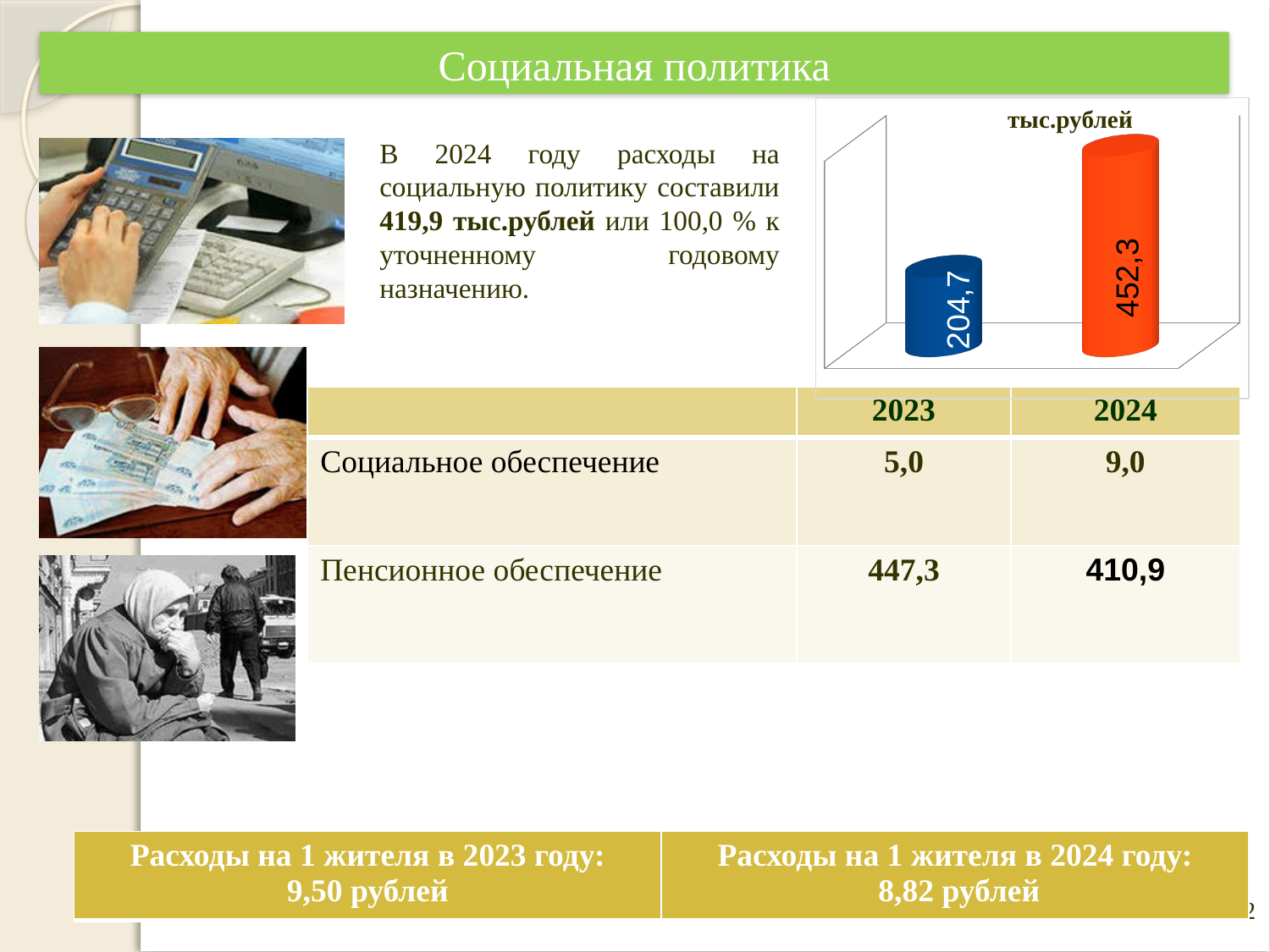
What type of chart is shown on the slide? bar chart How many bars are plotted in the chart? 2 What value is printed on the orange bar in the chart? 452,3 What value is printed on the blue bar in the chart? 204,7 What unit label is printed above the chart? тыс.рублей Is the value of the right bar larger or smaller than the value of the left bar? larger What is the difference between the values of the orange bar and the blue bar in the chart? 247,6 Which bar in the chart has the higher value, the blue one or the orange one? the orange one What value is shown on the left bar of the chart? 204,7 What value is shown on the right bar of the chart? 452,3 Which bar in the chart has the lower value, the left one or the right one? the left one What colour is the bar with the value 452,3? orange